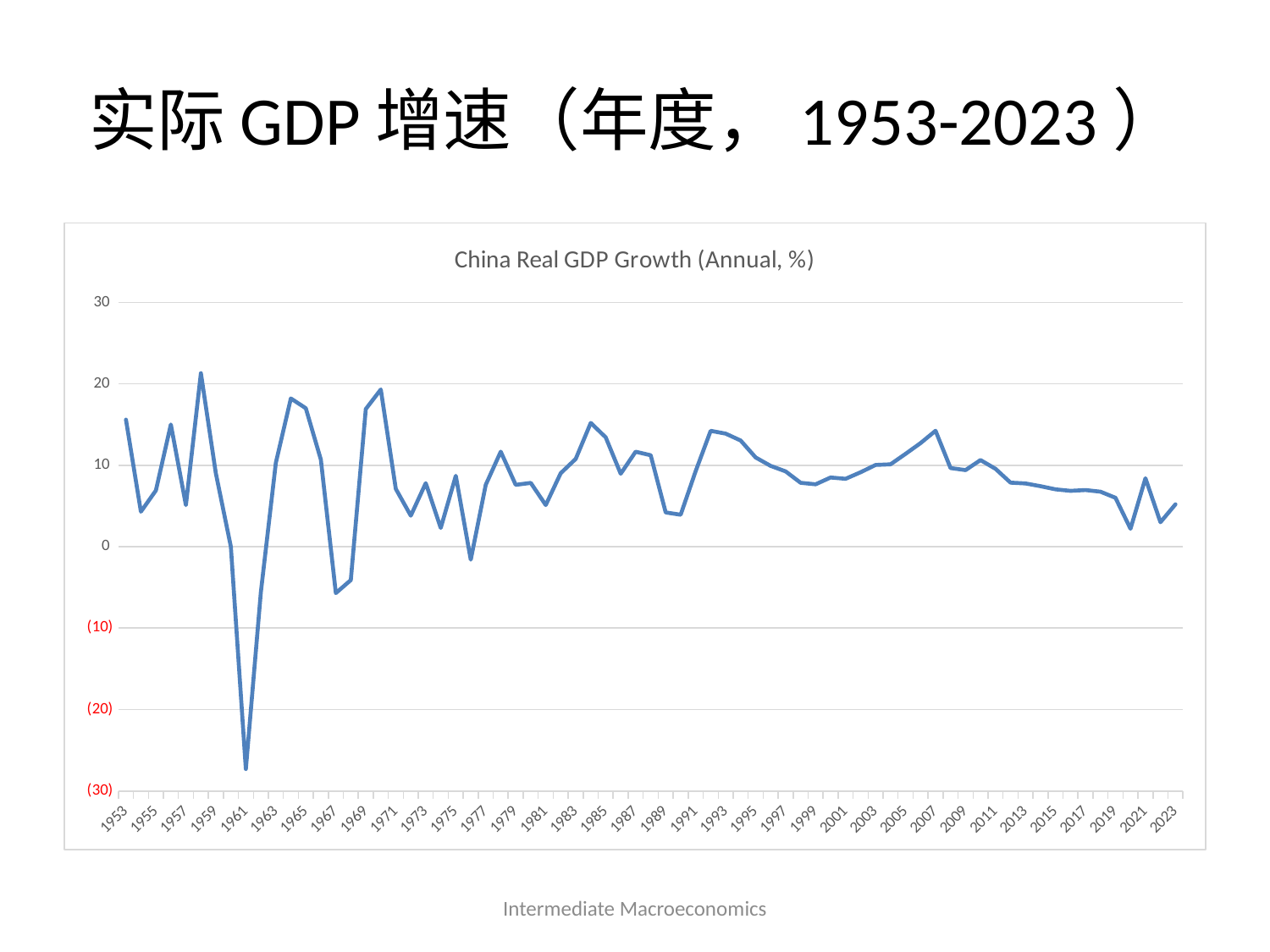
Is the value for 1970 greater or less than 10? greater Is the value for 2020 greater or less than 5? less Which year has the lowest real GDP growth on the chart? 1961 What kind of chart is shown on the slide? line chart Which year has the larger real GDP growth, 1970 or 1990? 1970 Which year has the highest real GDP growth on the chart? 1958 Is the value for 1961 greater or less than (20)? less What is the title of the chart? China Real GDP Growth (Annual, %) From 2007 to 2019, does real GDP growth generally rise or fall? fall Which year has the larger real GDP growth, 2007 or 2020? 2007